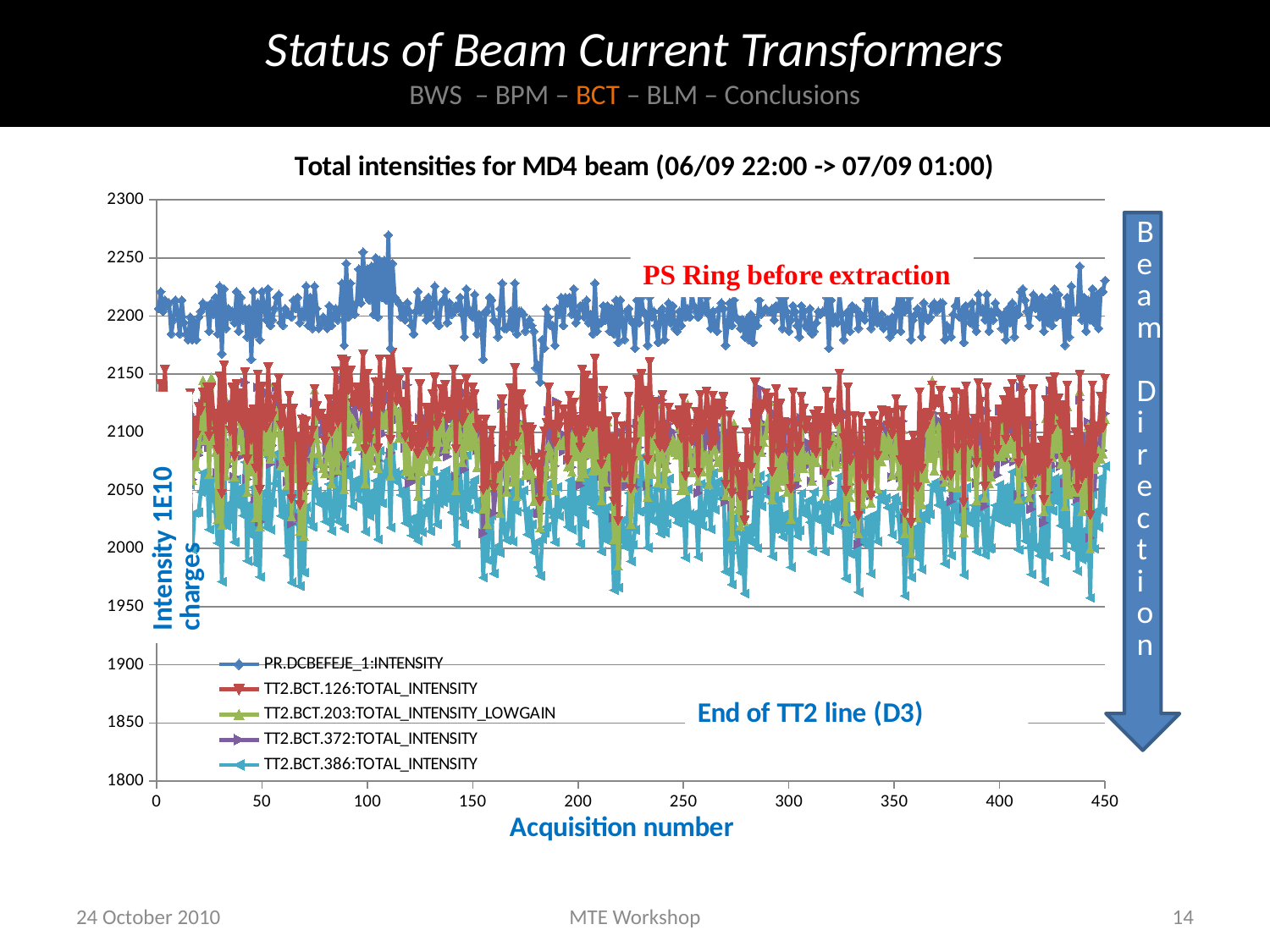
Are the values of the TT2.BCT.386:TOTAL_INTENSITY series greater or less than 1900? greater Which series in the chart has the highest values overall? PR.DCBEFEJE_1:INTENSITY What is the maximum value shown on the y axis of the chart? 2300 Which series in the chart has the lowest values overall? TT2.BCT.386:TOTAL_INTENSITY Which series has larger values, TT2.BCT.126:TOTAL_INTENSITY or TT2.BCT.386:TOTAL_INTENSITY? TT2.BCT.126:TOTAL_INTENSITY Are the values of the TT2.BCT.386:TOTAL_INTENSITY series greater or less than 2150? less Are the values of the PR.DCBEFEJE_1:INTENSITY series greater or less than 2150? greater How many series does the chart legend list? 5 What kind of chart is shown on the slide? Line chart What is the title of the chart? Total intensities for MD4 beam (06/09 22:00 -> 07/09 01:00) What is the label of the x axis of the chart? Acquisition number Which series has larger values, PR.DCBEFEJE_1:INTENSITY or TT2.BCT.126:TOTAL_INTENSITY? PR.DCBEFEJE_1:INTENSITY